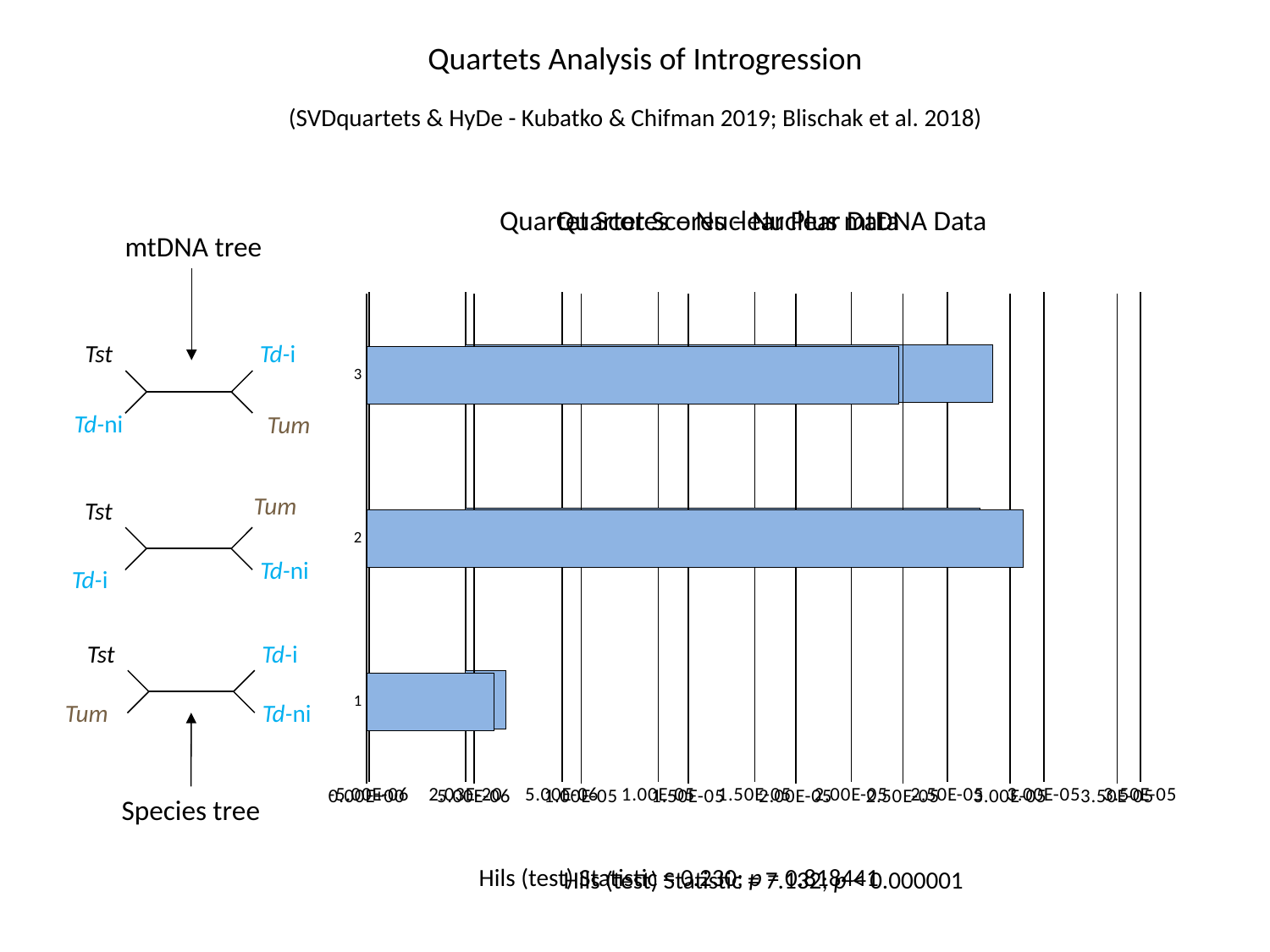
In the bar chart, is the bar for category 3 longer or shorter than the bar for category 1? longer In the bar chart, is the bar for category 2 longer or shorter than the bar for category 1? longer What colour are the bars in the chart? blue Which category has the shortest bar in the bar chart? 1 What kind of chart is shown on the right side of the slide? bar chart How many categories are plotted on the vertical axis of the bar chart? 3 Are the bars in the chart drawn horizontally or vertically? horizontally